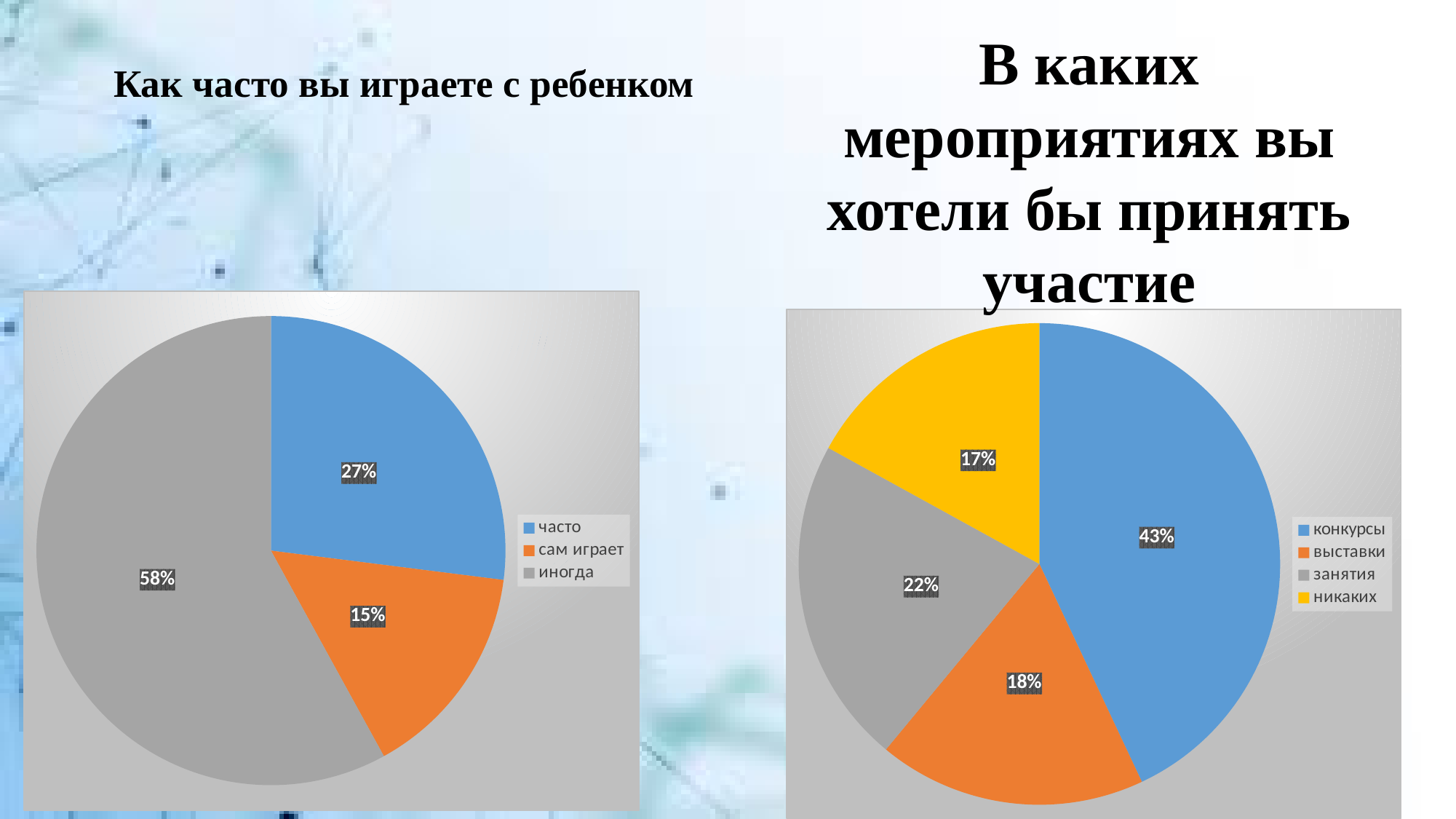
In the left chart 'Как часто вы играете с ребенком', which category has the smallest share? сам играет In the right chart 'В каких мероприятиях вы хотели бы принять участие', which is larger: 'выставки' or 'никаких'? выставки What type of chart is the left chart 'Как часто вы играете с ребенком'? pie chart In the right chart 'В каких мероприятиях вы хотели бы принять участие', what share does 'конкурсы' have? 43% In the left chart 'Как часто вы играете с ребенком', what is the difference between 'иногда' and 'часто'? 31% In the right chart 'В каких мероприятиях вы хотели бы принять участие', which category has the largest share? конкурсы In the left chart 'Как часто вы играете с ребенком', what share does 'часто' have? 27% In the right chart 'В каких мероприятиях вы хотели бы принять участие', how many categories does the legend list? 4 In the left chart 'Как часто вы играете с ребенком', what share does 'иногда' have? 58% In the right chart 'В каких мероприятиях вы хотели бы принять участие', what colour is the 'никаких' slice? yellow In the right chart 'В каких мероприятиях вы хотели бы принять участие', what share does 'занятия' have? 22% In the left chart 'Как часто вы играете с ребенком', how many slices does the pie have? 3